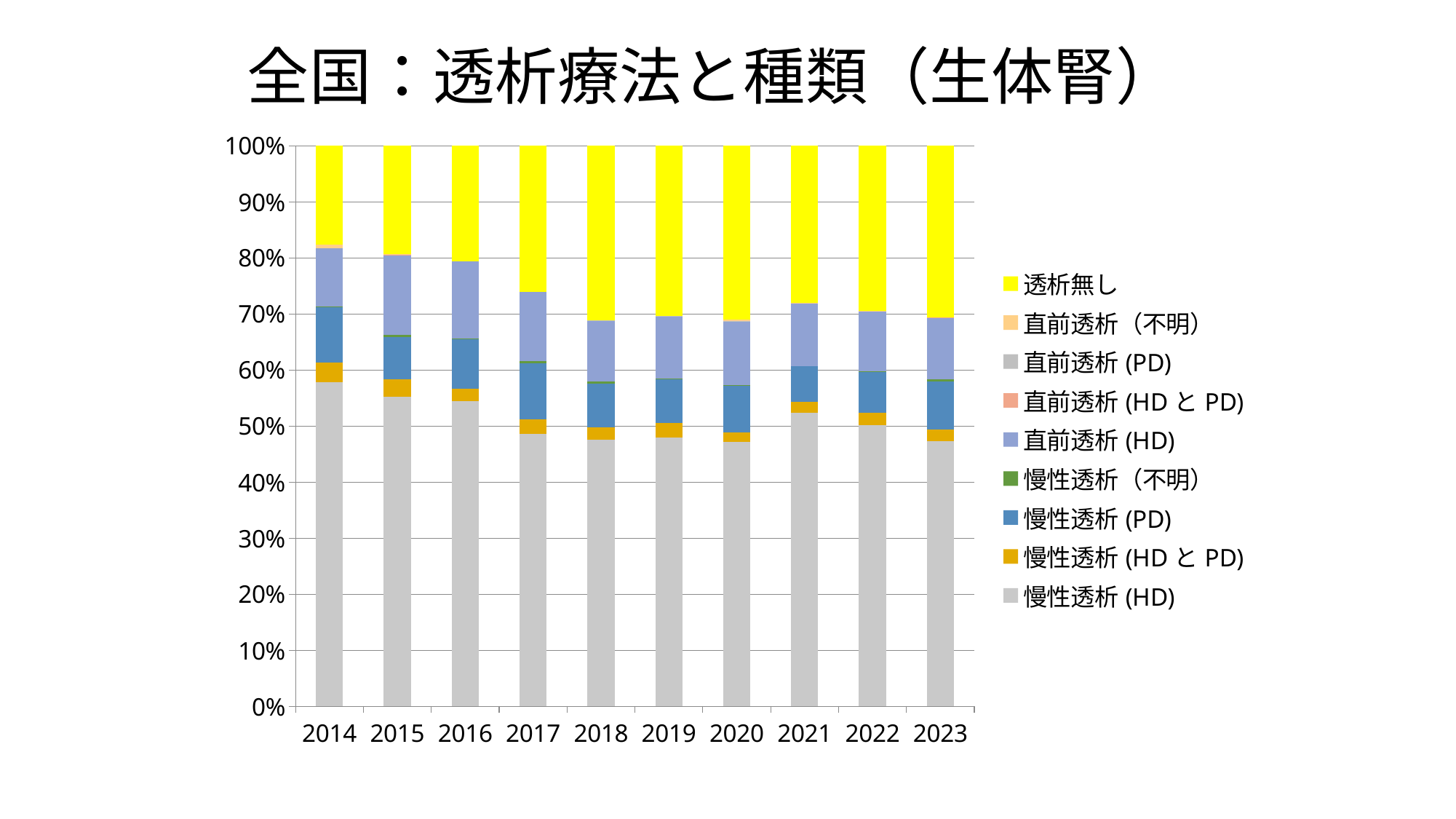
Is the value for 慢性透析 (HD) in 2014 greater or less than 50%? greater Does the 慢性透析 (HD) share rise or fall from 2014 to 2020? fall Is the value for 慢性透析 (HD) in 2020 greater or less than 50%? less How many years are shown along the x axis? 10 Which colour represents 透析無し in the chart? yellow What is the title of the chart? 全国：透析療法と種類（生体腎） Is the 透析無し share larger in 2014 or in 2018? 2018 What kind of chart is shown on the slide? stacked bar chart What is the total of the stacked bar for 2023? 100% How many series does the legend list? 9 Is the 慢性透析 (HD) share larger in 2014 or in 2020? 2014 In which year is the 慢性透析 (HD) share the highest? 2014